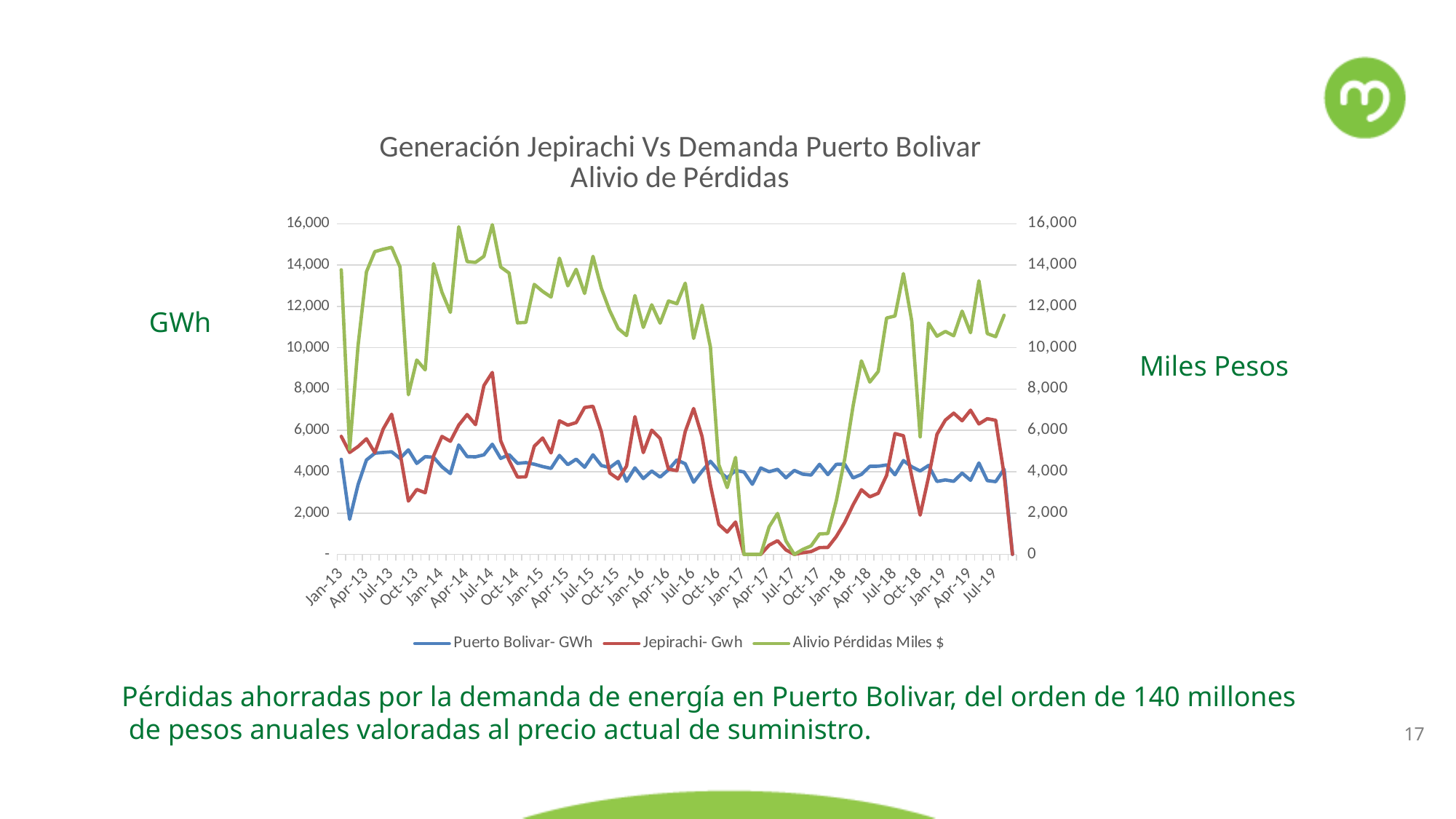
Is the value for Jepirachi- Gwh at Jul-17 greater or less than 2,000? less Is the value for Alivio Pérdidas Miles $ at Jan-13 greater or less than 12,000? greater Is the value for Alivio Pérdidas Miles $ at Apr-17 greater or less than 2,000? less How many series does the legend list? 3 Which series is drawn in green according to the legend? Alivio Pérdidas Miles $ At Jul-17, which series is plotted higher: Puerto Bolivar- GWh or Jepirachi- Gwh? Puerto Bolivar- GWh Does the Alivio Pérdidas Miles $ line rise or fall between Oct-17 and Apr-18? rise How many date labels are shown on the x axis? 27 What is the title of the chart? Generación Jepirachi Vs Demanda Puerto Bolivar Alivio de Pérdidas What kind of chart is shown on the slide? line chart